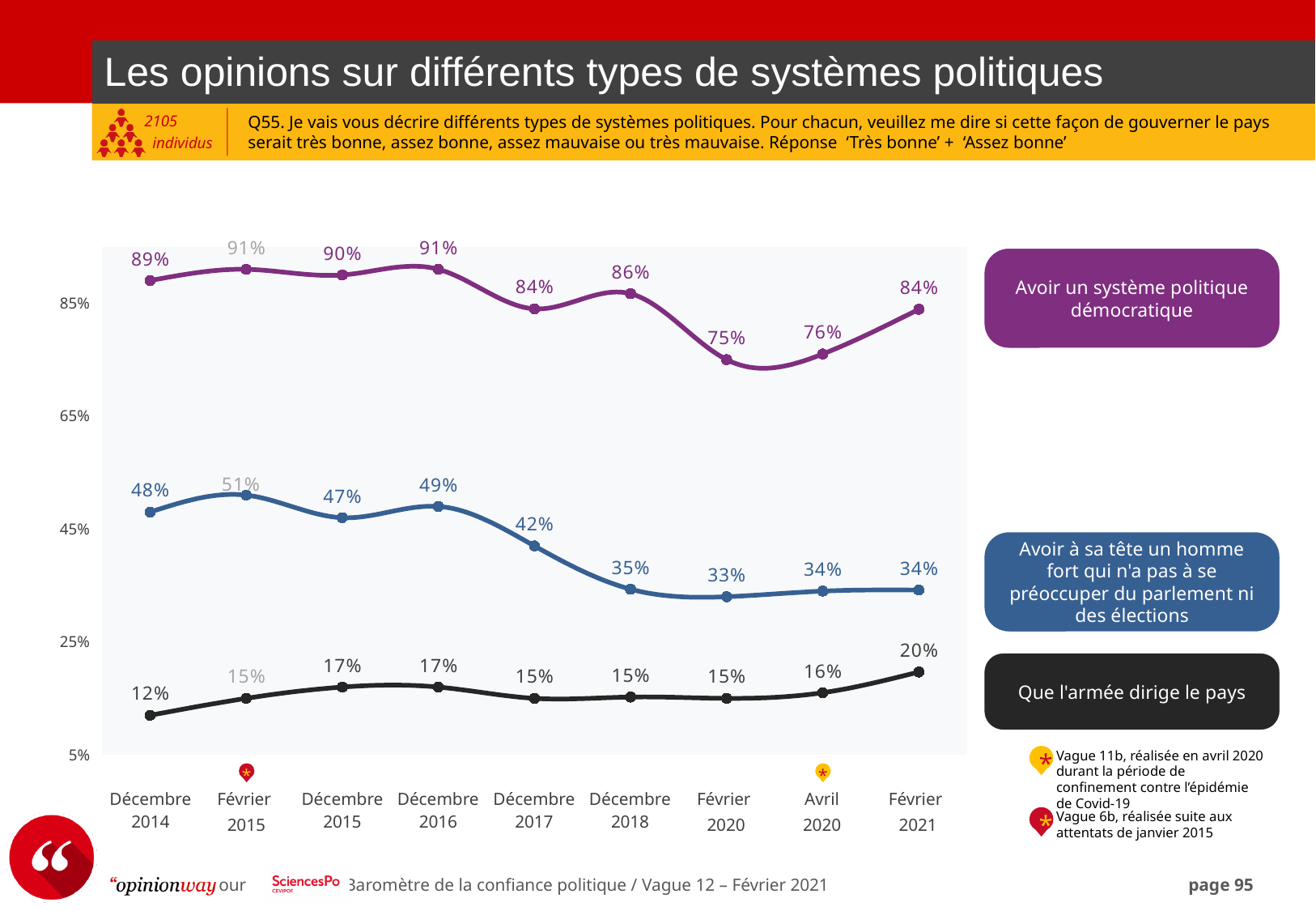
What is the value for 'Que l'armée dirige le pays' in Décembre 2014? 12% What is the value for 'Avoir à sa tête un homme fort qui n'a pas à se préoccuper du parlement ni des élections' in Décembre 2017? 42% How many time points are plotted along the x axis? 9 How many series does the chart show? 3 What is the value for 'Avoir un système politique démocratique' in Février 2021? 84% Does the 'Avoir à sa tête un homme fort' series generally rise or fall from Décembre 2014 to Février 2021? fall What is the difference between the 'Avoir à sa tête un homme fort' values in Décembre 2014 and Février 2021? 14 points What type of chart is shown on the slide? line chart At which time point is the value for 'Avoir un système politique démocratique' lowest? Février 2020 Which is larger: the 'Avoir un système politique démocratique' value in Décembre 2016 or in Avril 2020? Décembre 2016 At which time point is the value for 'Que l'armée dirige le pays' highest? Février 2021 Which colour is used for the 'Que l'armée dirige le pays' series? black